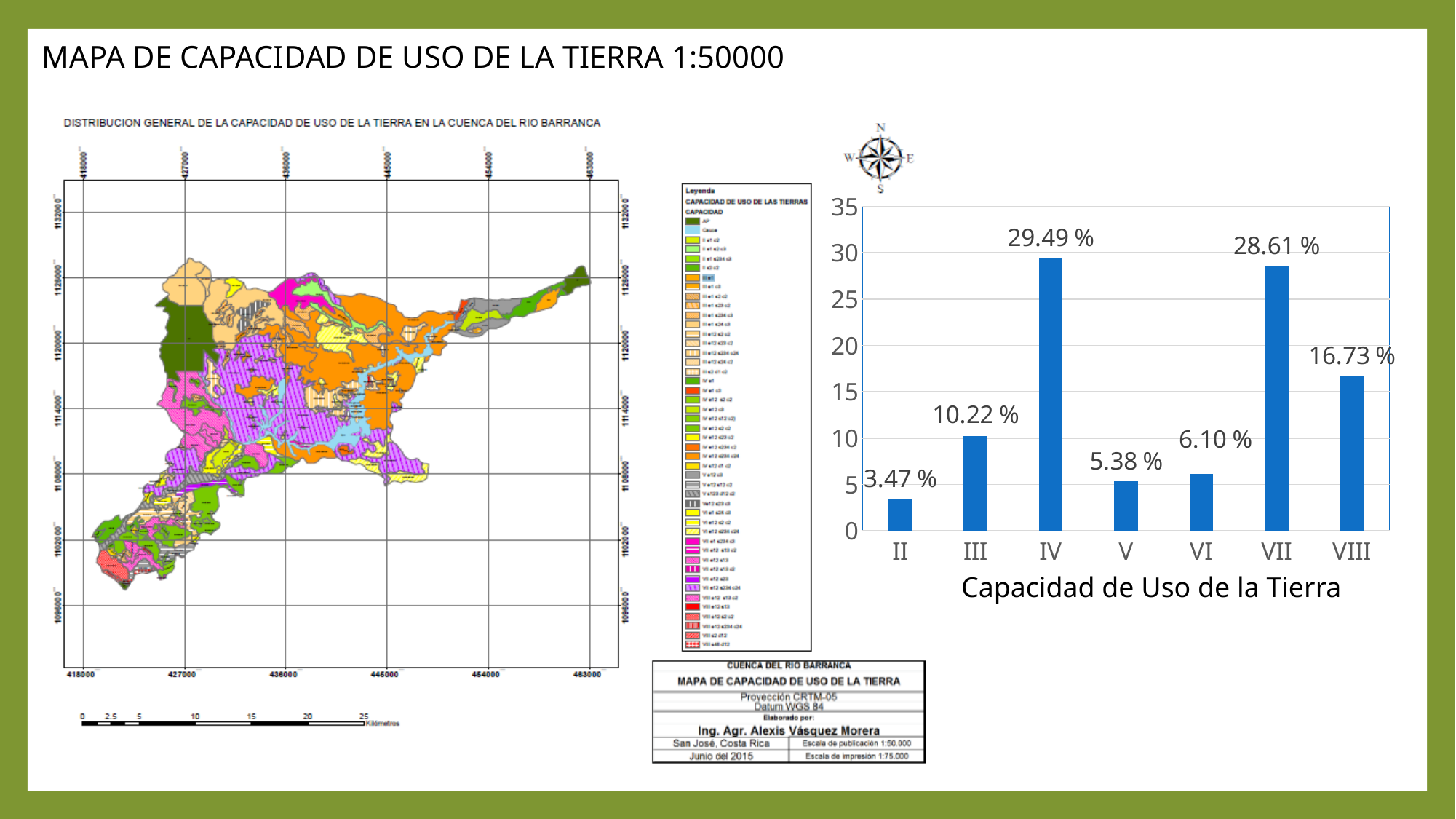
In the bar chart, what is the difference between the values for IV and VII? 0.88 % In the bar chart, what is the value for category VI? 6.10 % In the bar chart, which is larger, the value for VII or the value for VIII? VII How many categories are shown on the x axis of the bar chart? 7 In the bar chart, what is the value for category IV? 29.49 % In the bar chart, which category has the highest value? IV In the bar chart, is the value for category III greater or less than 15? less In the bar chart, what is the value for category II? 3.47 % In the bar chart, what is the difference between the values for VIII and III? 6.51 % In the bar chart, what is the value for category VIII? 16.73 % In the bar chart, which category has the lowest value? II What is the x-axis title of the bar chart? Capacidad de Uso de la Tierra